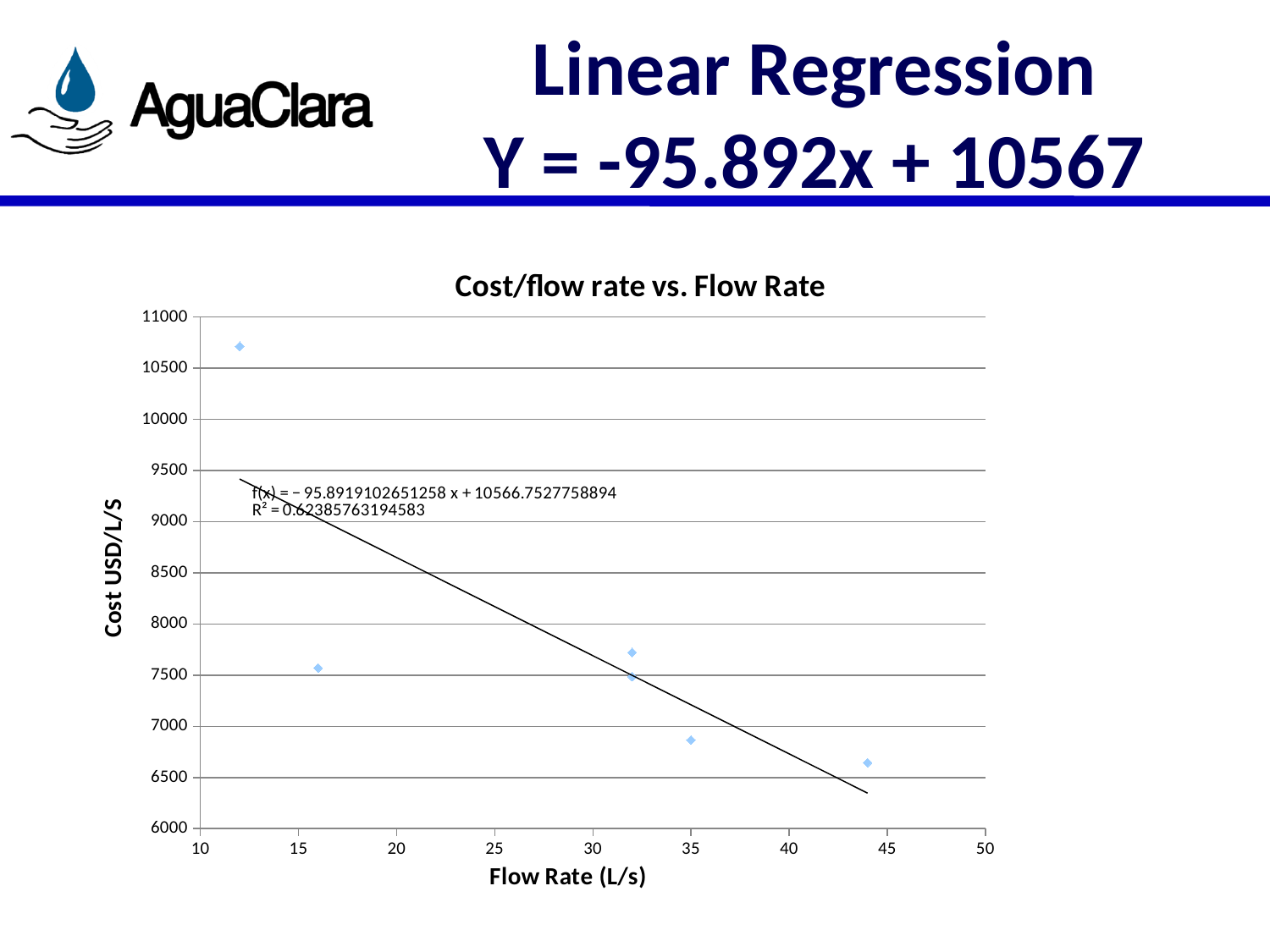
What kind of chart is shown on the slide? scatter chart Do the plotted cost values generally rise or fall as flow rate increases? fall Is the cost value for the point at a flow rate of 44 L/s greater or less than 7000? less Is the cost value for the point at a flow rate of 16 L/s greater or less than 8000? less How many data points are plotted on the chart? 6 Is the cost value for the point at a flow rate of 12 L/s greater or less than 10500? greater Which point has the higher cost value: the one at a flow rate of 12 L/s or the one at 44 L/s? 12 L/s At which flow rate is the plotted cost value lowest? 44 L/s What R² value is printed on the chart? 0.62385763194583 What is the title of the chart? Cost/flow rate vs. Flow Rate At which flow rate is the plotted cost value highest? 12 L/s